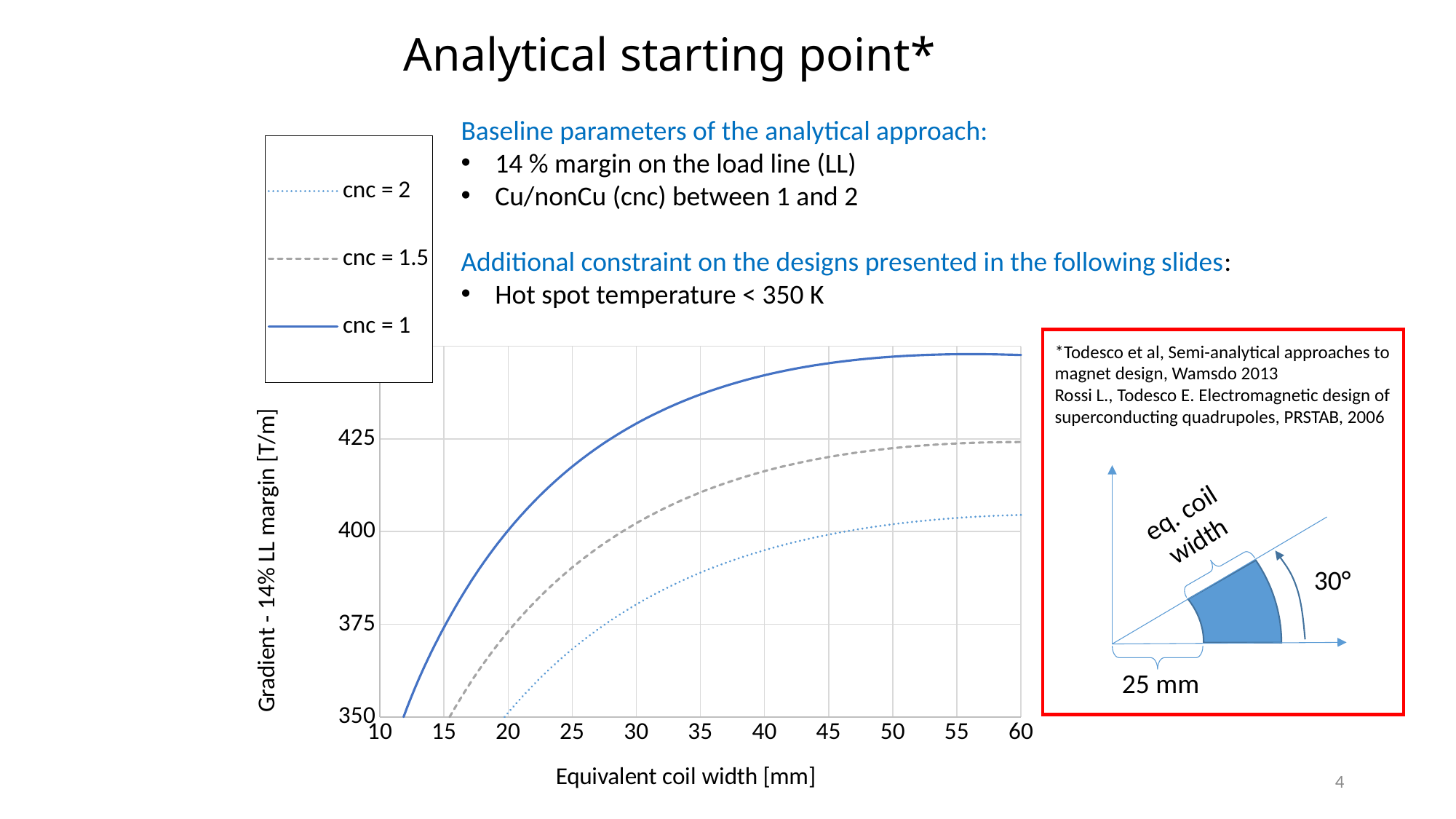
Is the value for cnc = 1 at an equivalent coil width of 60 mm greater or less than 425? greater What is the label of the x axis of the chart? Equivalent coil width [mm] What kind of chart is shown on the slide? line chart At an equivalent coil width of 40 mm, which series has the larger gradient, cnc = 1 or cnc = 2? cnc = 1 Is the value for cnc = 1.5 at an equivalent coil width of 40 mm greater or less than 400? greater Do the gradient values rise or fall as the equivalent coil width increases? rise Is the value for cnc = 2 at an equivalent coil width of 30 mm greater or less than 400? less Which series has the lowest gradient at an equivalent coil width of 60 mm? cnc = 2 How many series does the chart legend list? 3 What is the label of the y axis of the chart? Gradient - 14% LL margin [T/m] Which series has the highest gradient at an equivalent coil width of 60 mm? cnc = 1